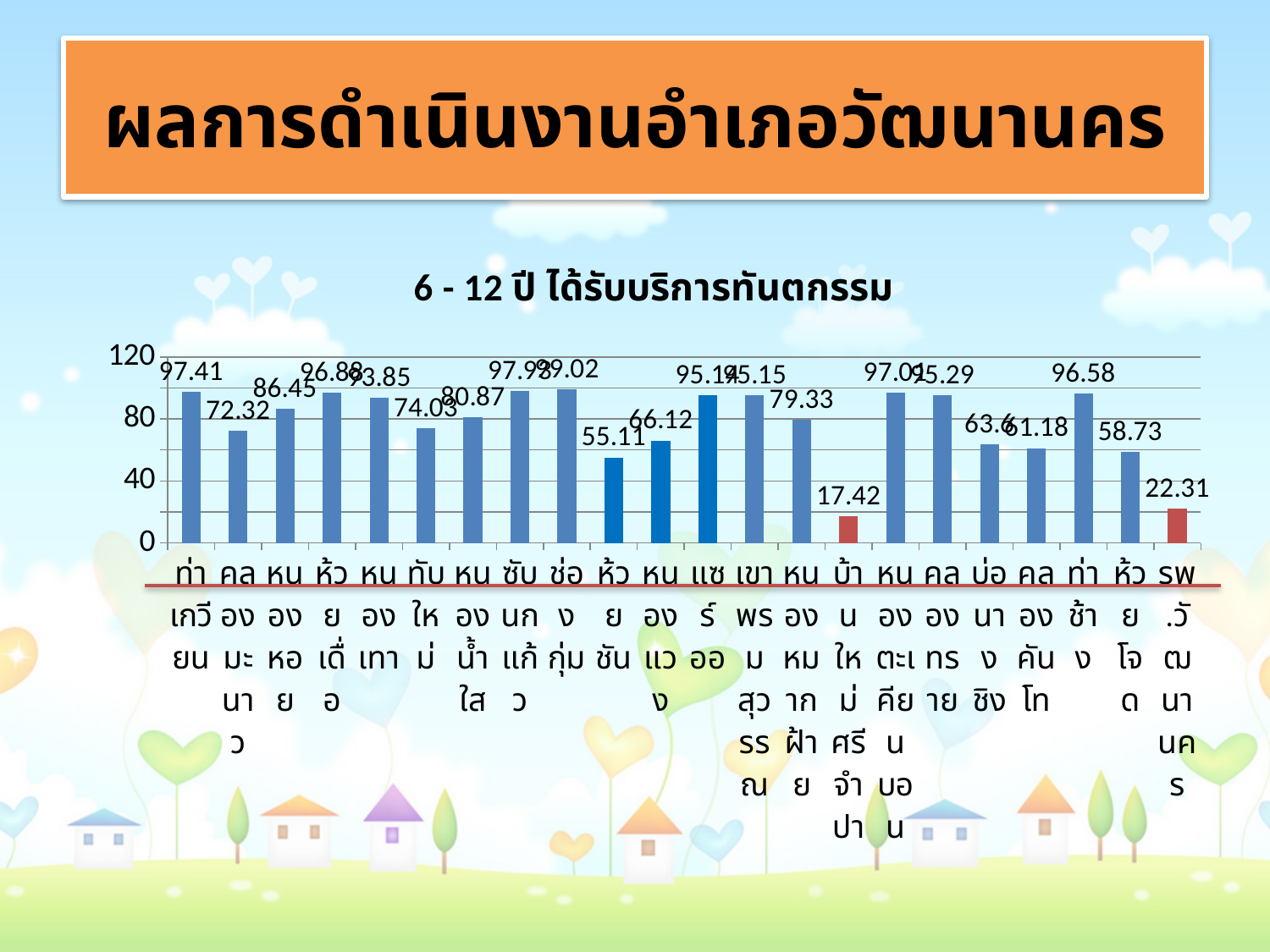
What is the value for ท่าช้าง? 96.58 How many bars (categories) are plotted in the chart? 22 What is the value for รพ.วัฒนานคร? 22.31 What is the value for ท่าเกวียน? 97.41 What is the value for คลองมะนาว? 72.32 What kind of chart is shown on the slide? bar chart What is the title of the chart? 6 - 12 ปี ได้รับบริการทันตกรรม What is the difference between the values for ท่าเกวียน and คลองมะนาว? 25.09 Which is larger, the value for ห้วยชัน or the value for หนองแวง? หนองแวง Which category has the highest value? ช่องกุ่ม What is the value for ห้วยชัน? 55.11 Which category has the lowest value? บ้านใหม่ศรีจำปา